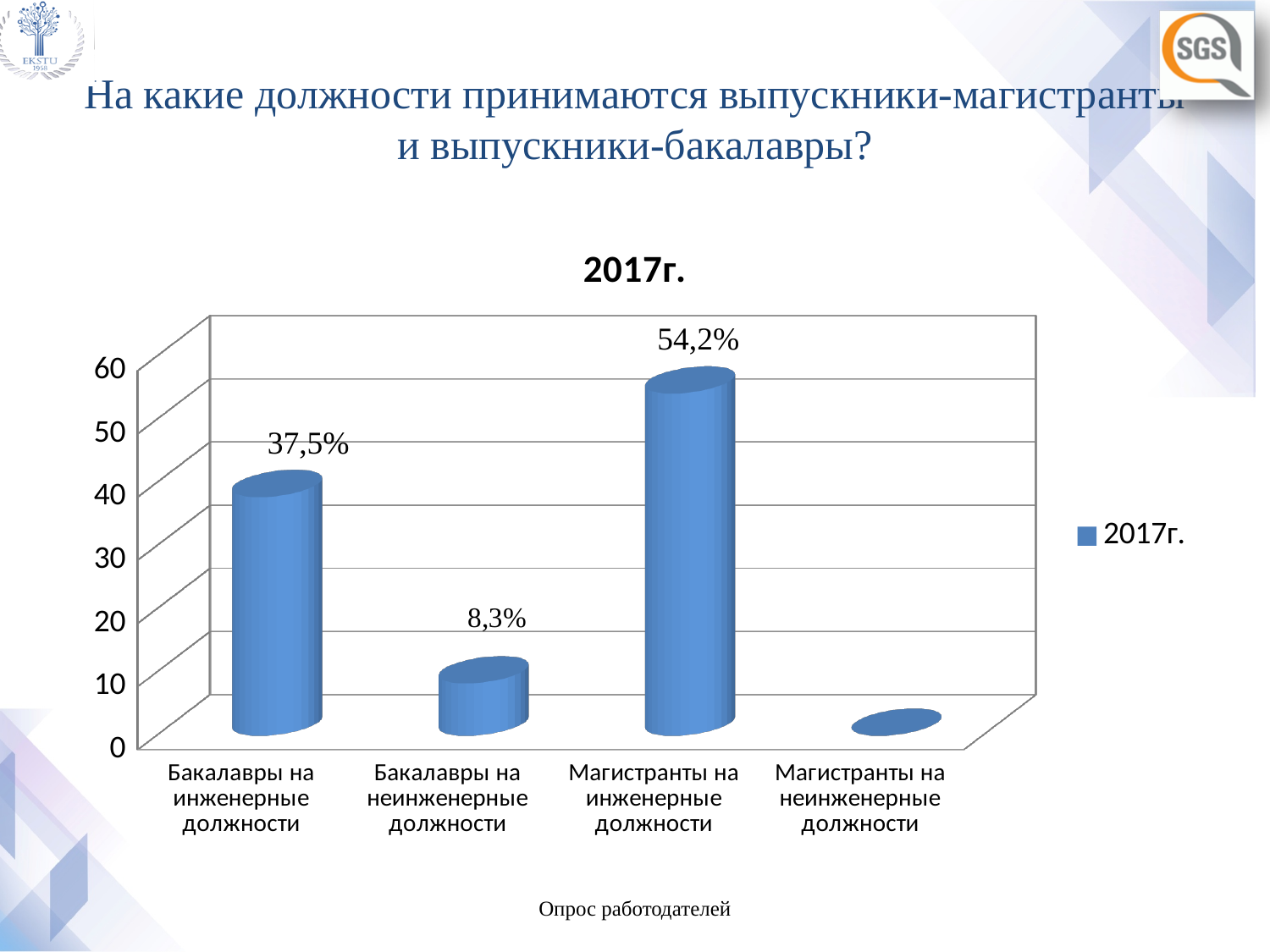
What is the difference between the values for Магистранты на инженерные должности and Бакалавры на инженерные должности? 16,7 percentage points What kind of chart is shown on the slide? bar chart Which category has the lowest value? Магистранты на неинженерные должности What is the difference between the values for Бакалавры на инженерные должности and Бакалавры на неинженерные должности? 29,2 percentage points How many series does the legend list? 1 Is the value for Магистранты на неинженерные должности greater or less than 10? less What is the value for Магистранты на инженерные должности? 54,2% Which is larger: the value for Бакалавры на инженерные должности or Магистранты на инженерные должности? Магистранты на инженерные должности How many categories are shown on the x axis? 4 Which category has the highest value? Магистранты на инженерные должности What is the value for Бакалавры на неинженерные должности? 8,3% What is the value for Бакалавры на инженерные должности? 37,5%